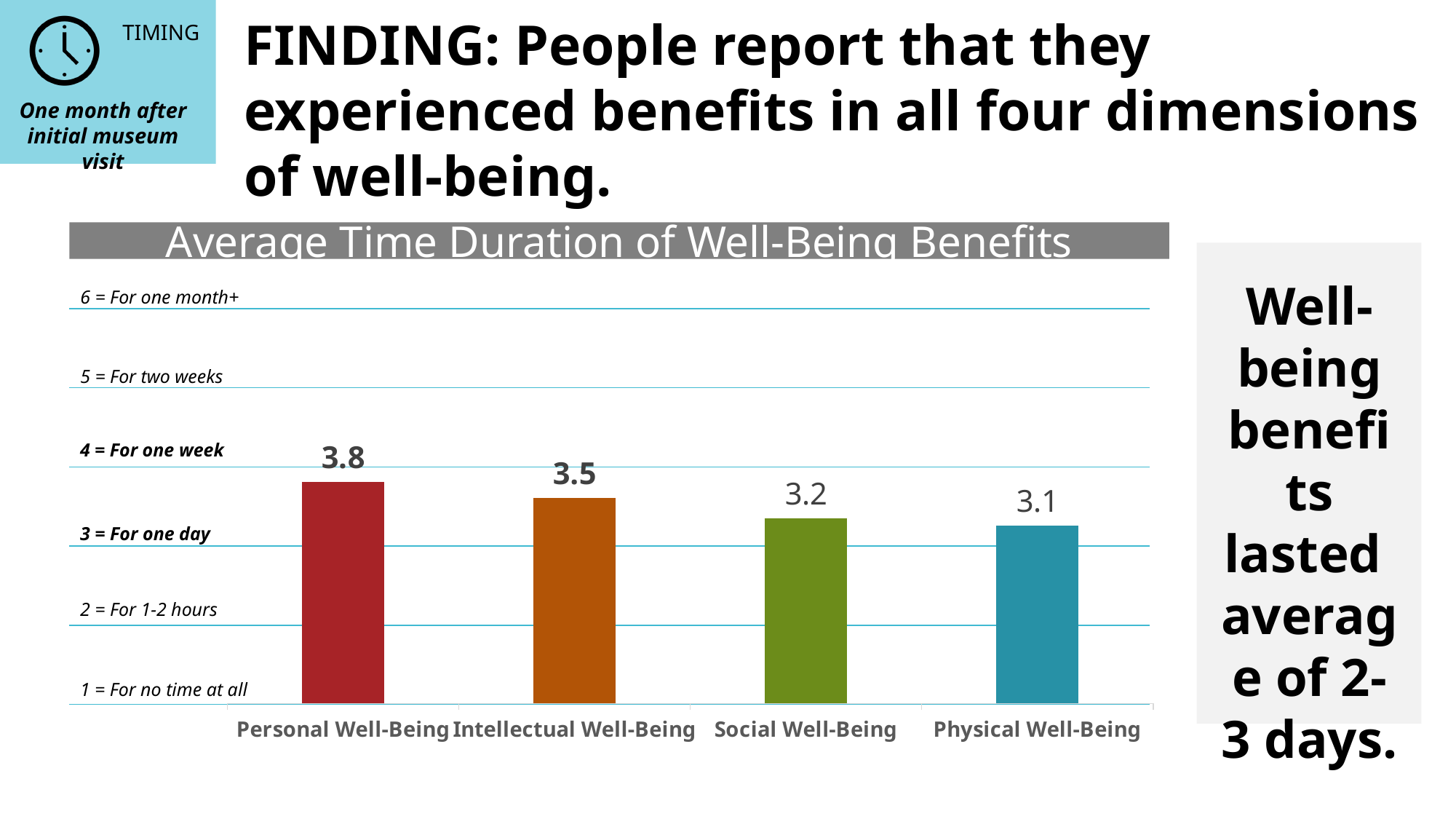
What is the value for Personal Well-Being? 3.8 Which is larger, the value for Intellectual Well-Being or Social Well-Being? Intellectual Well-Being What is the title of the chart? Average Time Duration of Well-Being Benefits What is the value for Intellectual Well-Being? 3.5 What kind of chart is shown on the slide? bar chart Is the value for Social Well-Being greater or less than 4? less What is the value for Physical Well-Being? 3.1 How many categories are shown in the chart? 4 What is the value for Social Well-Being? 3.2 What is the difference between the values for Personal Well-Being and Physical Well-Being? 0.7 Which category has the lowest value? Physical Well-Being Which category has the highest value? Personal Well-Being